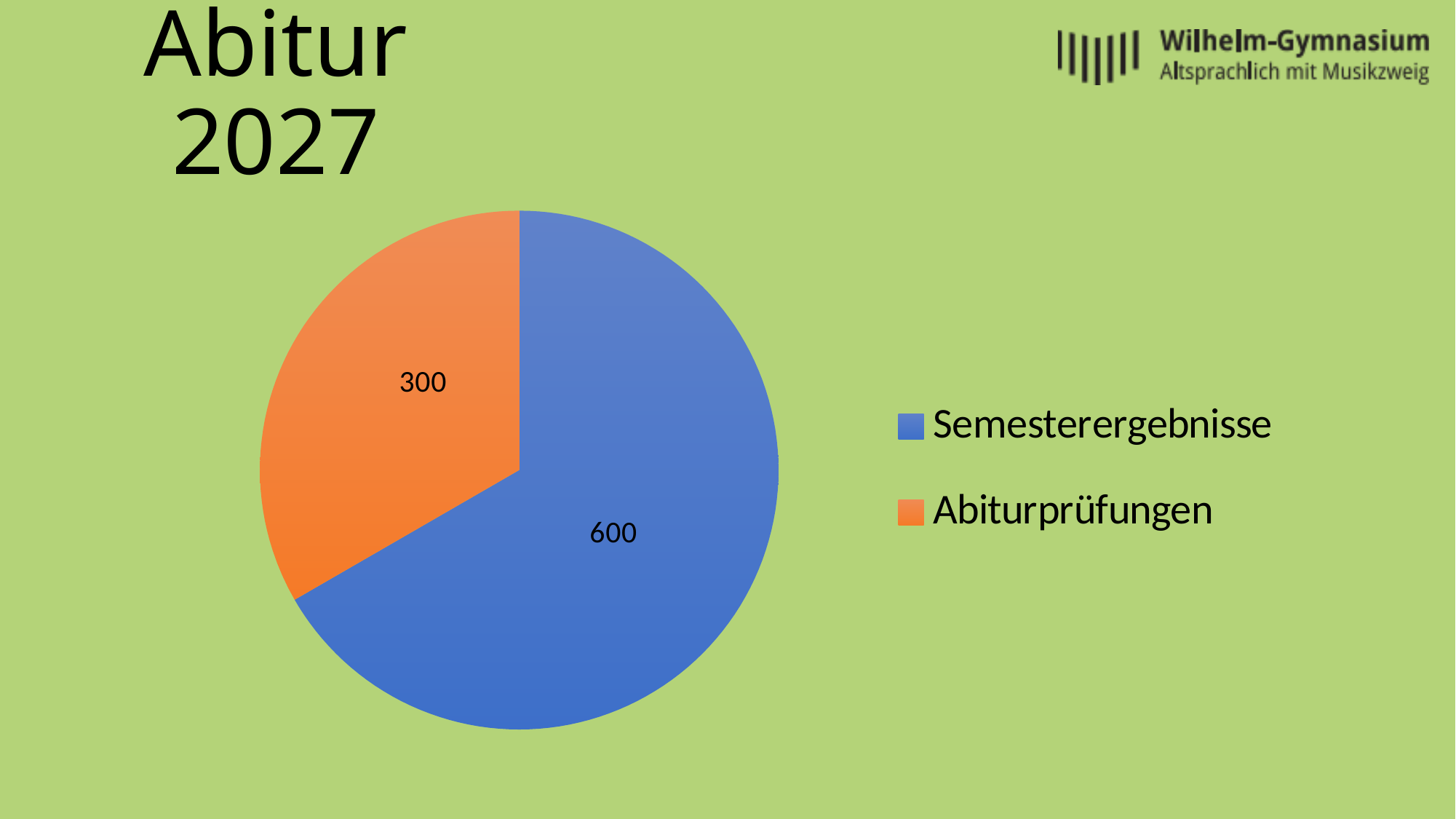
Which slice is the smallest? Abiturprüfungen Which slice is the largest? Semesterergebnisse What is the value for Abiturprüfungen? 300 What is the value for Semesterergebnisse? 600 What is the difference between the values for Semesterergebnisse and Abiturprüfungen? 300 What share of the pie does Abiturprüfungen represent? one third Which is larger, Semesterergebnisse or Abiturprüfungen? Semesterergebnisse What kind of chart is shown on the slide? pie chart What is the total of the two slices? 900 How many slices does the pie chart have? 2 What colour is the Abiturprüfungen slice? orange How many entries does the legend list? 2